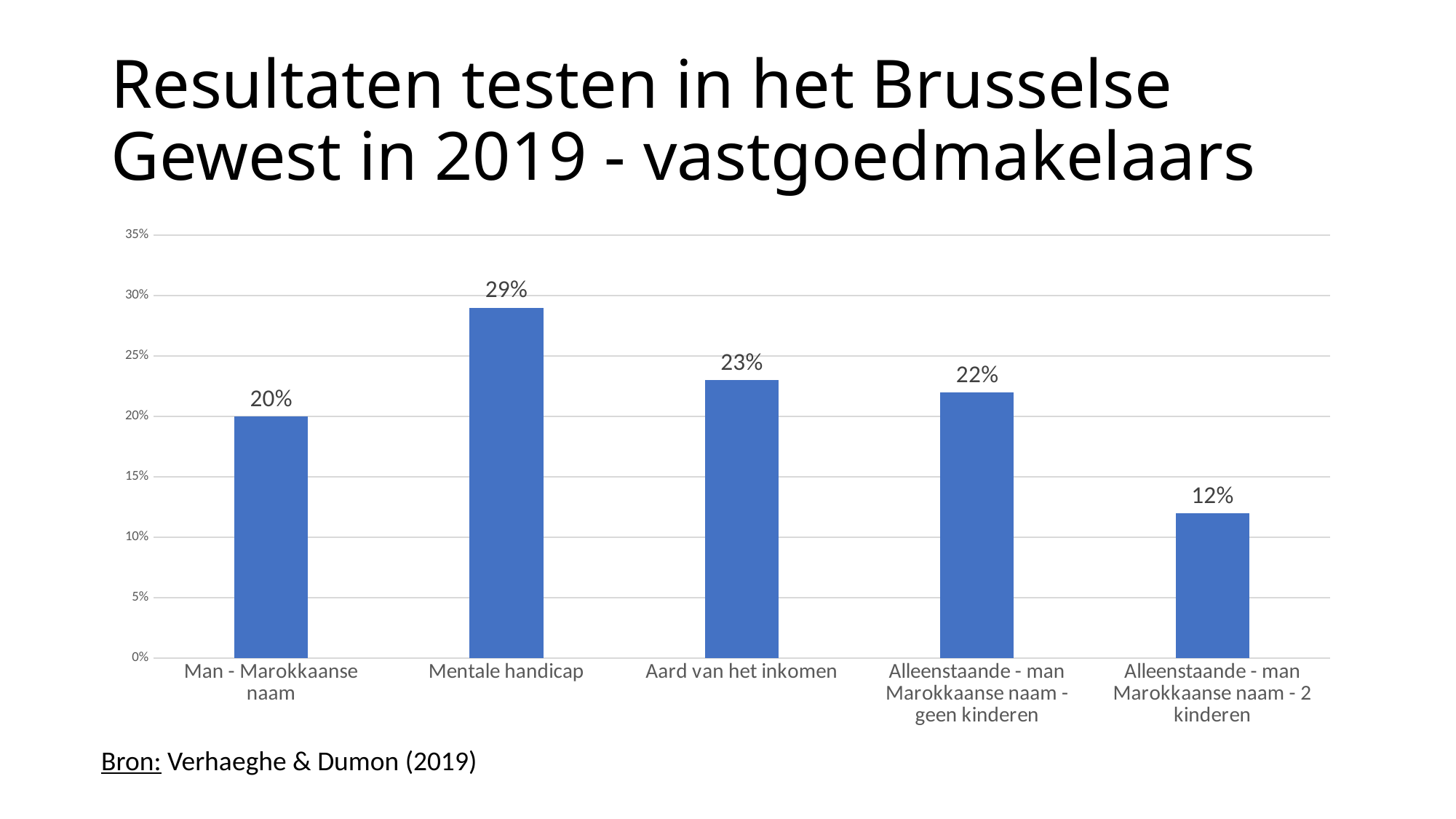
Which category has the highest value? Mentale handicap What is the value for Man - Marokkaanse naam? 20% What is the difference between the values for Mentale handicap and Man - Marokkaanse naam? 9% What kind of chart is shown on the slide? bar chart What source is cited below the chart? Verhaeghe & Dumon (2019) Is the value for Alleenstaande - man Marokkaanse naam - geen kinderen greater or less than 25%? less How many categories are shown in the chart? 5 What is the value for Alleenstaande - man Marokkaanse naam - 2 kinderen? 12% What is the value for Mentale handicap? 29% What is the value for Aard van het inkomen? 23% Which category has the lowest value? Alleenstaande - man Marokkaanse naam - 2 kinderen Which is larger: the value for Aard van het inkomen or the value for Alleenstaande - man Marokkaanse naam - geen kinderen? Aard van het inkomen